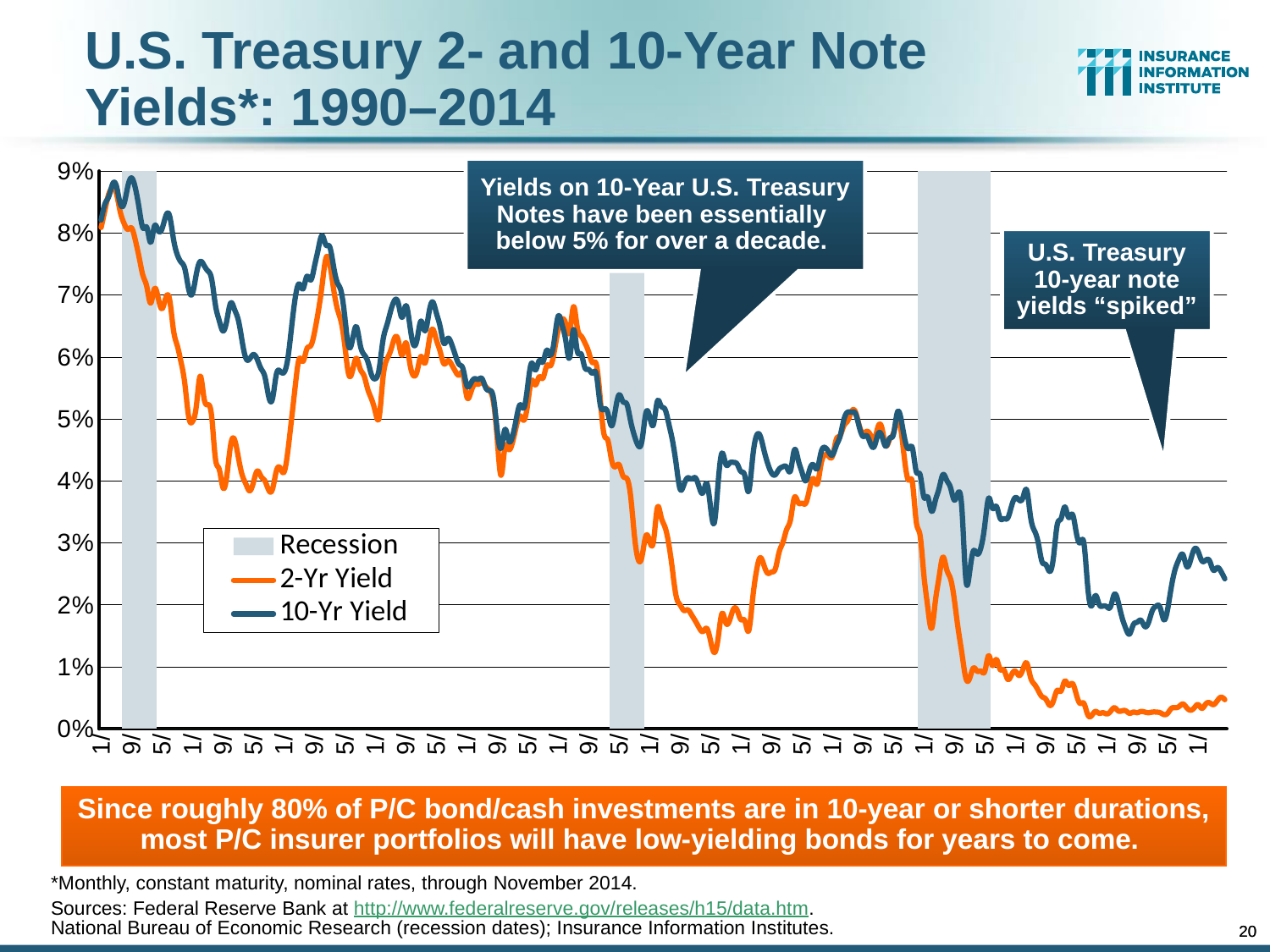
At the right end of the chart, which is higher, the 2-Yr Yield or the 10-Yr Yield? 10-Yr Yield How many yield series are plotted on the chart? 2 What kind of chart is shown on the slide? line chart How many shaded recession periods appear on the chart? 3 Is the 2-Yr Yield at the right end of the chart greater or less than 1%? less Which colour is used for the 2-Yr Yield line? orange Is the 10-Yr Yield at the right end of the chart greater or less than 2%? greater How many entries does the chart's legend list? 3 Is the 10-Yr Yield at the start of the chart (1990) greater or less than 8%? greater What is the highest value shown on the chart's vertical axis? 9% What does the grey shading on the chart represent, according to the legend? Recession Overall, do the Treasury yields rise or fall from the left of the chart to the right? fall